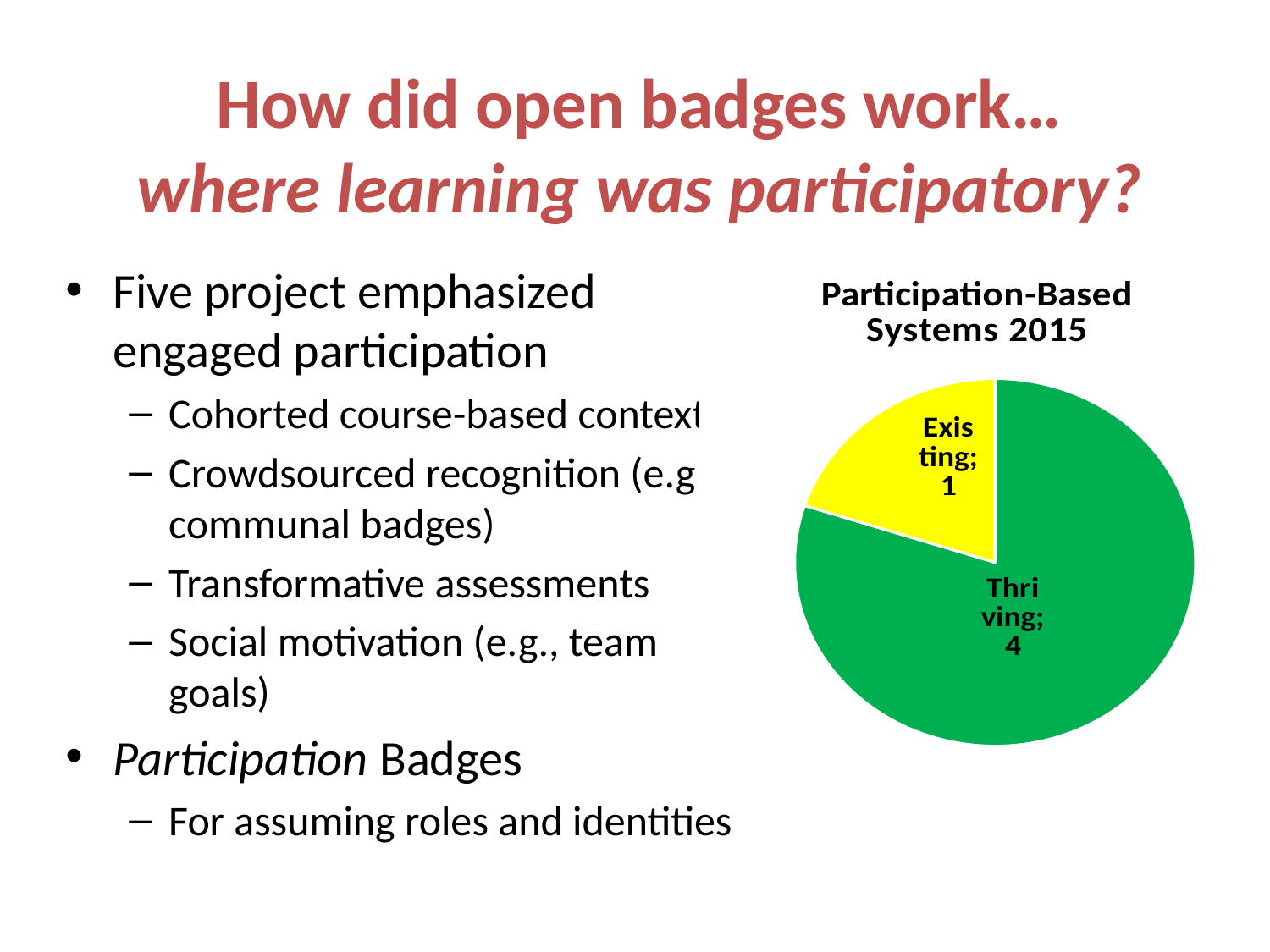
What is the title of the pie chart? Participation-Based Systems 2015 What is the value for Existing in the pie chart? 1 What colour is the Existing slice? yellow Which category has the smallest slice in the pie chart? Existing What kind of chart is shown on the slide? pie chart What is the difference between the Thriving and Existing values? 3 Which category has the largest slice in the pie chart? Thriving What is the value for Thriving in the pie chart? 4 What is the total of all slices in the pie chart? 5 What share of the pie does the Thriving slice represent? 80% Which is larger, Thriving or Existing? Thriving How many slices does the pie chart have? 2